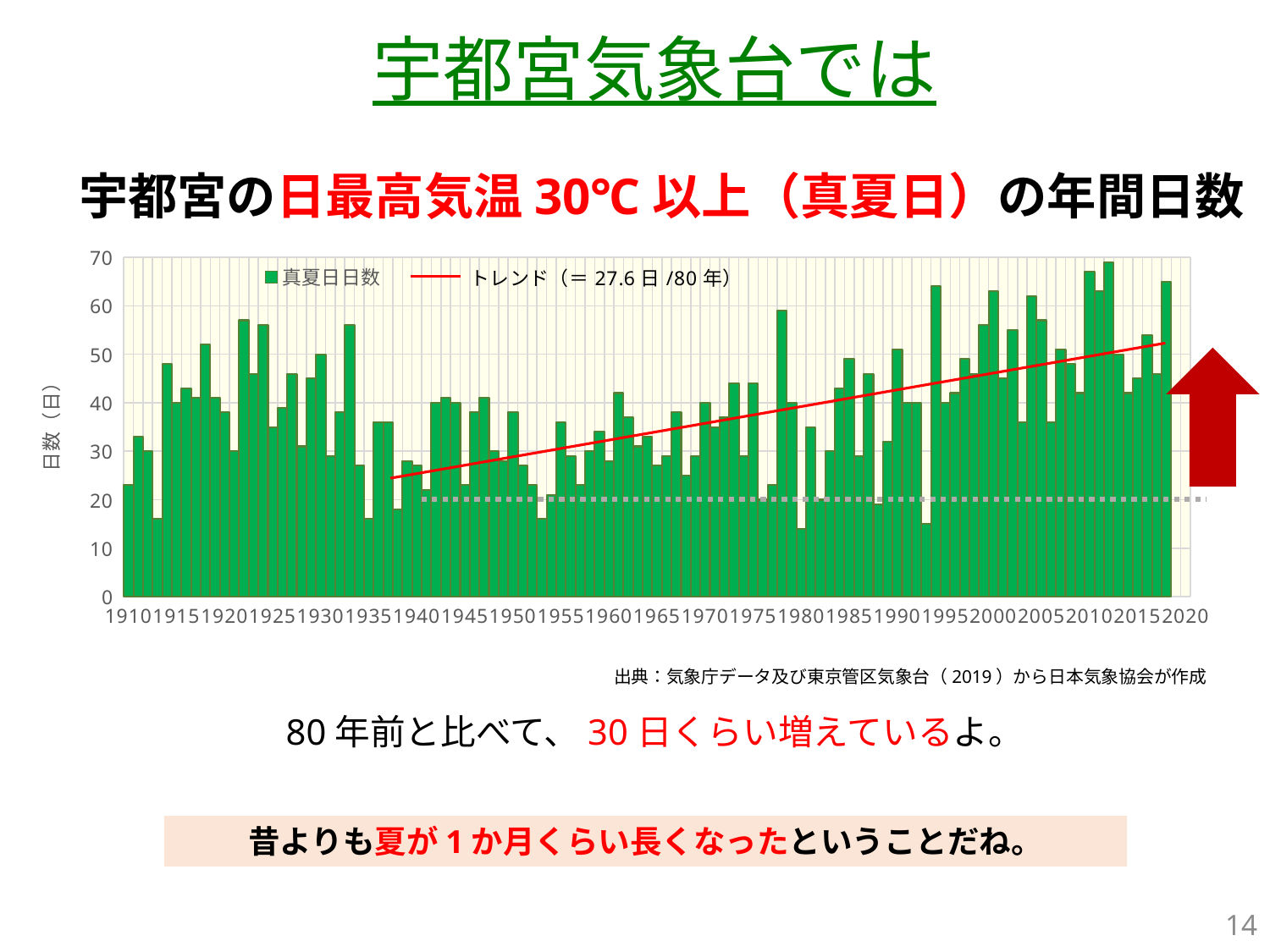
Is the value for the first bar (1910) greater or less than 30? less What is the label of the y axis of the chart? 日数（日） What kind of chart is shown on the slide? bar chart What is the highest value shown on the y axis of the chart? 70 What is the last year shown on the x axis of the chart? 2020 Overall, do the values in the chart rise or fall from 1910 to 2020? rise How many entries does the chart legend list? 2 What is the first year shown on the x axis of the chart? 1910 What is the name of the bar series in the chart legend? 真夏日日数 According to the legend, what is the trend rate shown for the chart? 27.6 日/80 年